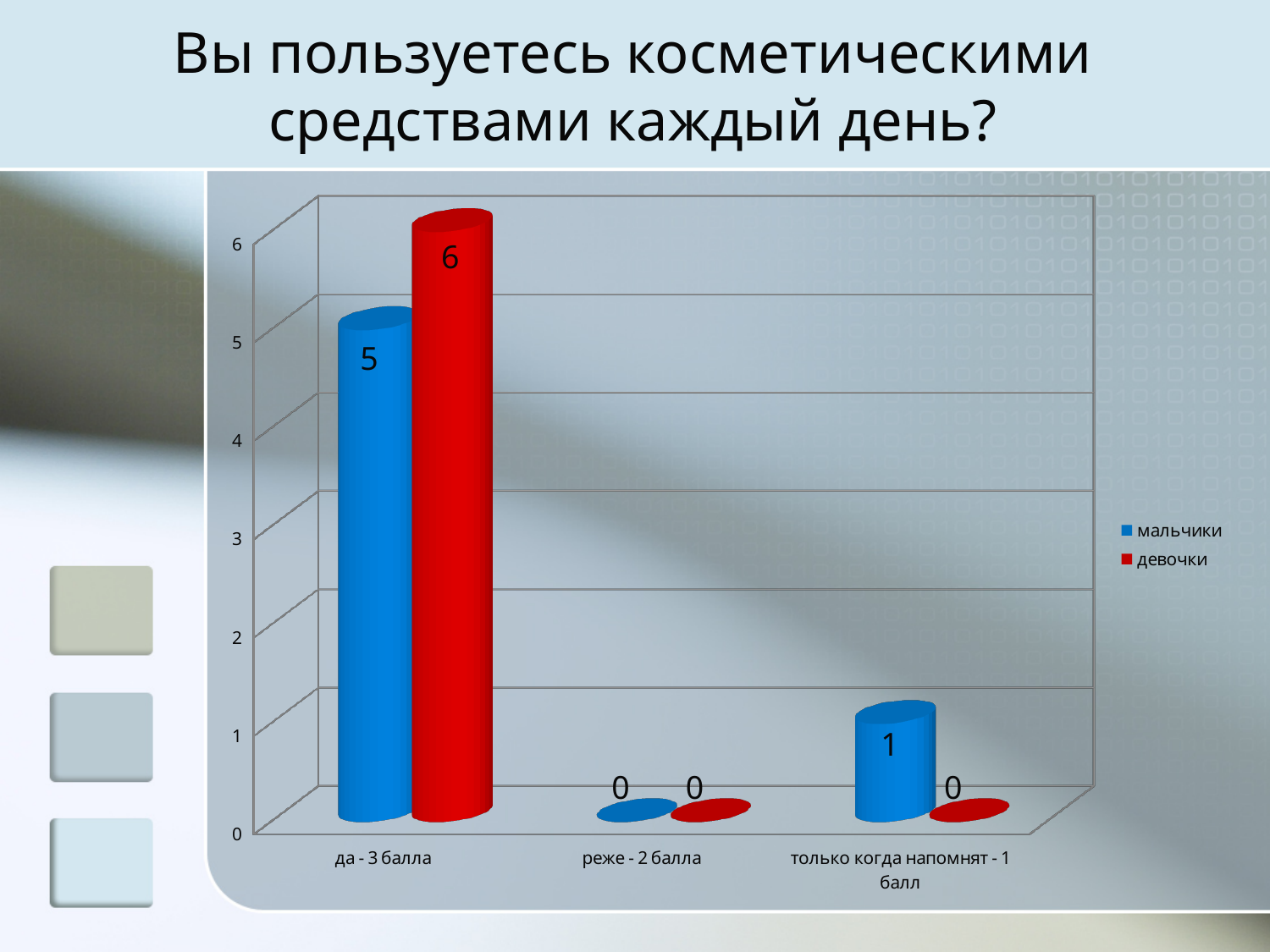
What is the value for мальчики in the category 'только когда напомнят - 1 балл'? 1 What is the value for мальчики in the category 'да - 3 балла'? 5 Do the values for мальчики rise or fall from 'да - 3 балла' to 'реже - 2 балла'? fall How many categories are shown on the x axis? 3 What is the value for девочки in the category 'да - 3 балла'? 6 What is the value for девочки in the category 'реже - 2 балла'? 0 How many series does the legend list? 2 In the category 'да - 3 балла', which series has the larger value, мальчики or девочки? девочки Which category has the highest value for девочки? да - 3 балла What kind of chart is shown on the slide? bar chart What is the difference between the девочки and мальчики values in the category 'да - 3 балла'? 1 Which colour represents the series девочки in the legend? red